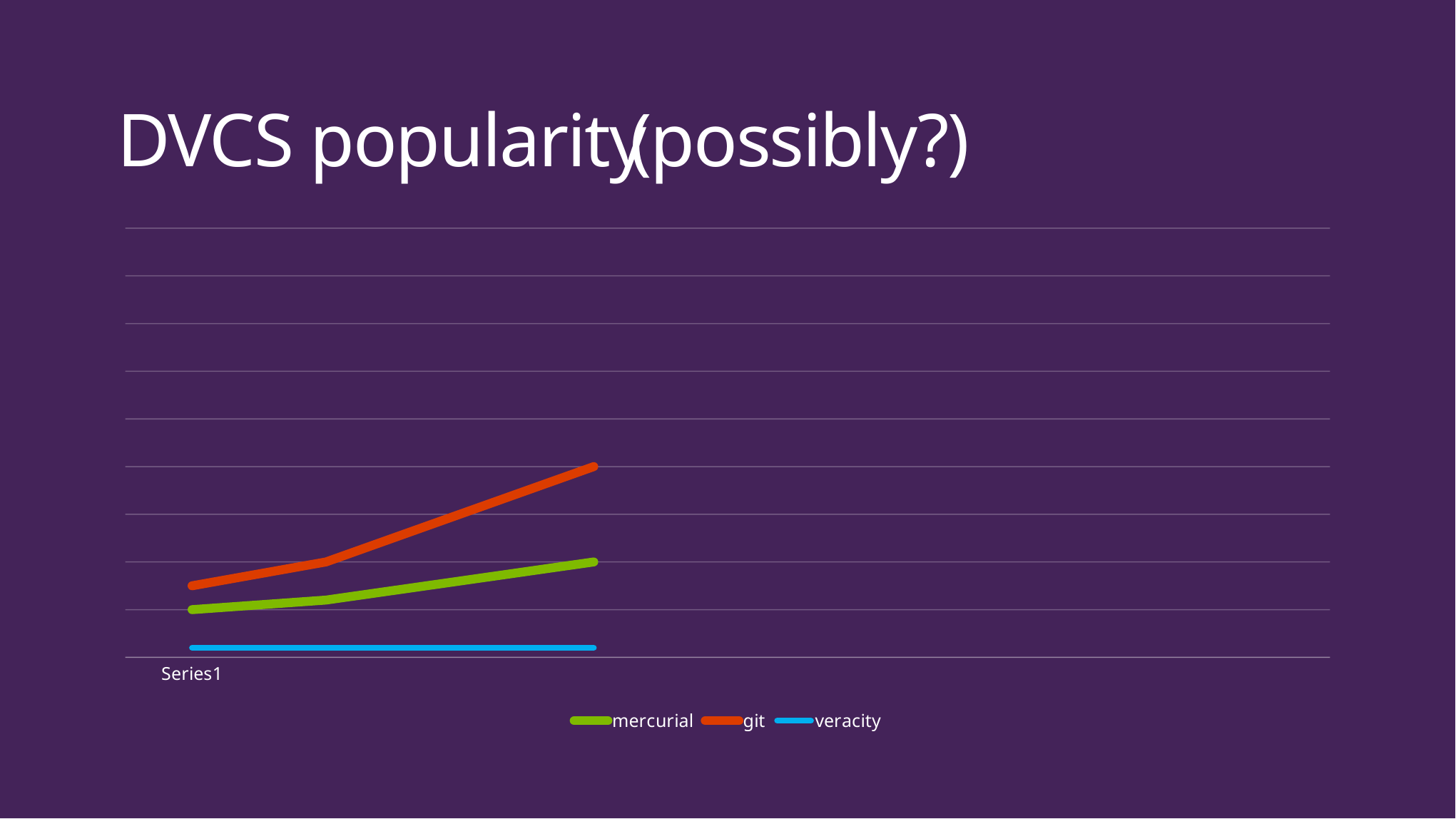
How many series does the legend list? 3 Which series has the lowest values across the chart? veracity Which series has the highest value at the right end of the chart? git At the right end of the chart, which is larger, the value for git or the value for mercurial? git Does the veracity line rise, fall, or stay flat from left to right? stay flat Which is larger at the left end of the chart, the value for mercurial or the value for veracity? mercurial Which series are listed in the legend? mercurial, git, veracity What kind of chart is shown on the slide? line chart What is the title of the slide containing the chart? DVCS popularity (possibly?) Does the mercurial line rise or fall from left to right? rise Does the git line rise or fall from left to right? rise